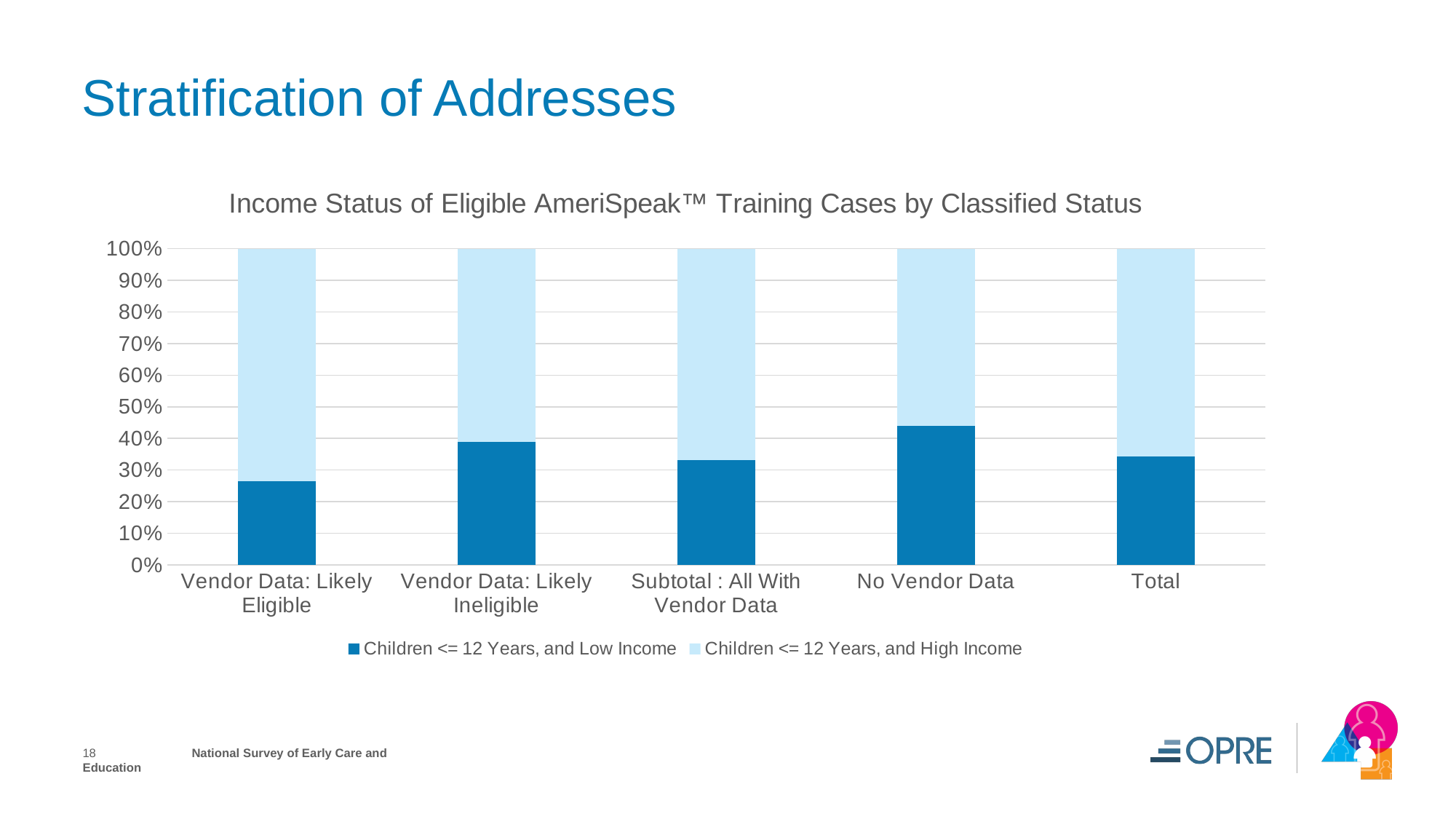
What kind of chart is shown on the slide? Stacked bar chart Which category has the lowest share of Children <= 12 Years, and Low Income? Vendor Data: Likely Eligible Which has a larger share of Children <= 12 Years, and Low Income: Vendor Data: Likely Eligible or Vendor Data: Likely Ineligible? Vendor Data: Likely Ineligible Is the share of Children <= 12 Years, and Low Income for No Vendor Data greater or less than 40%? greater Is the share of Children <= 12 Years, and Low Income for Total greater or less than 30%? greater What is the title of the chart? Income Status of Eligible AmeriSpeak™ Training Cases by Classified Status Which series is shown in dark blue in the chart? Children <= 12 Years, and Low Income Which category has the highest share of Children <= 12 Years, and Low Income? No Vendor Data Is the share of Children <= 12 Years, and Low Income for Vendor Data: Likely Eligible greater or less than 30%? less How many categories are shown on the x axis of the chart? 5 How many series does the chart's legend list? 2